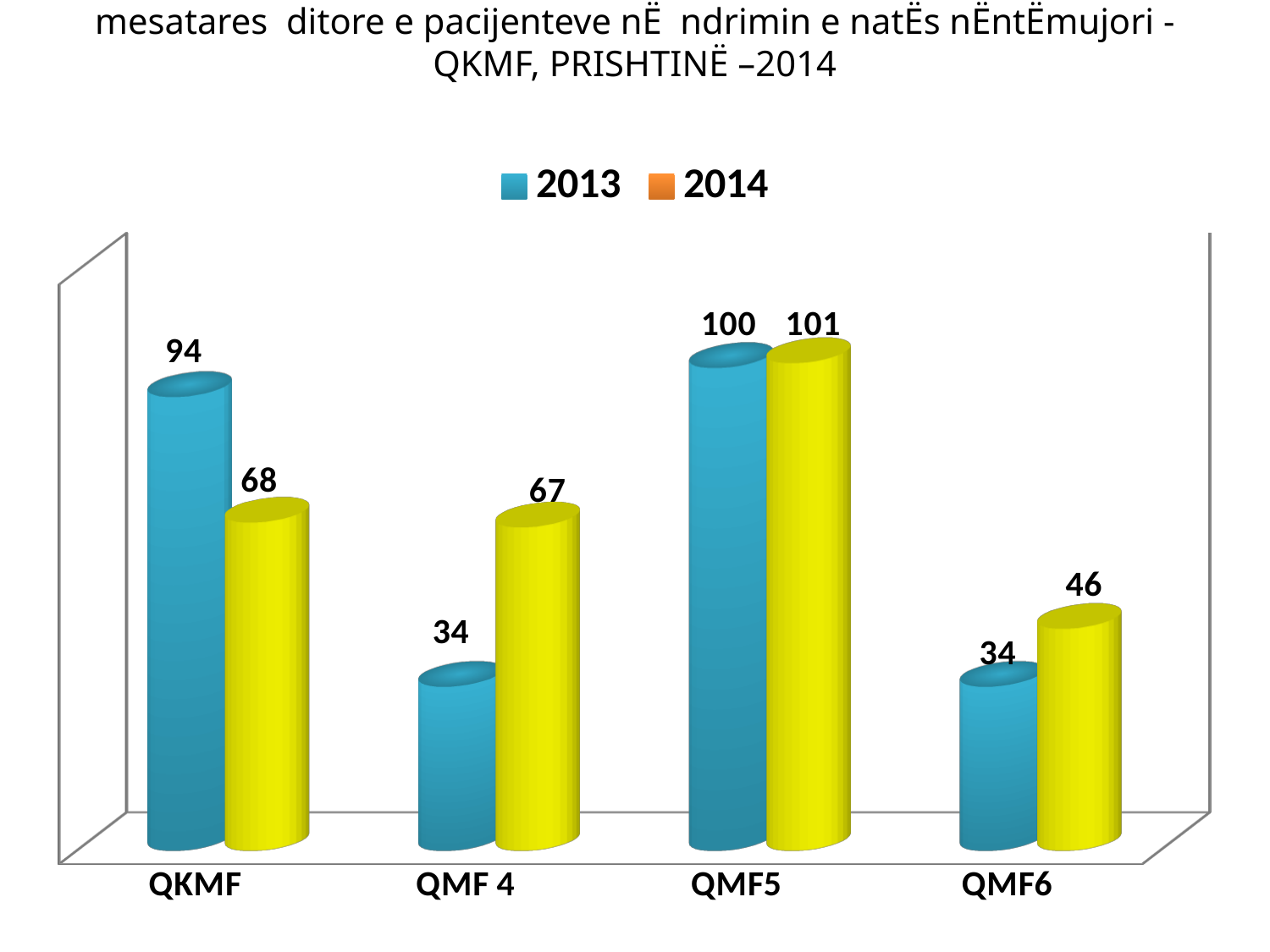
What is the 2014 value for QMF6? 46 What kind of chart is shown on the slide? Bar chart Which category has the highest 2013 value? QMF5 What is the 2014 value for QMF 4? 67 Which is larger for QMF 4: the 2013 value or the 2014 value? 2014 What is the 2013 value for QKMF? 94 Which category has the lowest 2014 value? QMF6 How many categories are shown on the x axis? 4 Which is larger: the 2013 value for QKMF or the 2013 value for QMF6? QKMF How many series does the legend list? 2 What is the difference between the 2014 values for QMF 4 and QMF6? 21 What is the difference between the 2013 and 2014 values for QKMF? 26